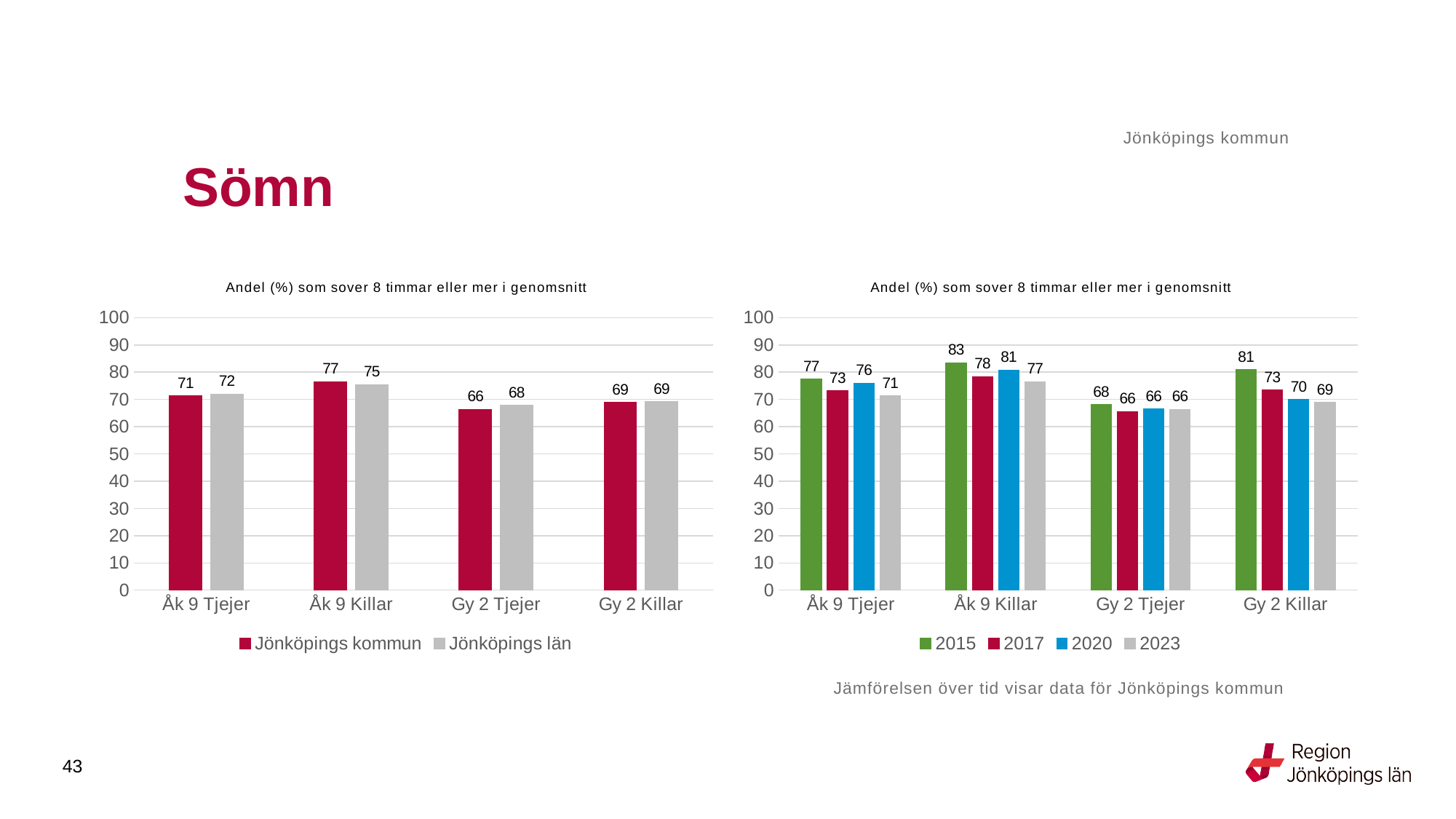
In the right chart, what is the value for 2015 for Åk 9 Killar? 83 What kind of chart is the right chart? Bar chart In the left chart, what is the value for Jönköpings län for Gy 2 Tjejer? 68 In the right chart, which year has the highest value for Gy 2 Killar? 2015 In the left chart, how many series does the legend list? 2 In the right chart, what is the value for 2020 for Gy 2 Killar? 70 In the right chart, how many categories are shown on the x axis? 4 In the left chart, what is the value for Jönköpings kommun for Åk 9 Killar? 77 In the left chart, which category has the lowest value for Jönköpings kommun? Gy 2 Tjejer In the right chart, which is larger for Åk 9 Tjejer: the 2017 value or the 2020 value? 2020 In the left chart, what is the difference between Jönköpings kommun and Jönköpings län for Åk 9 Killar? 2 In the right chart, what is the difference between the 2015 and 2023 values for Gy 2 Killar? 12